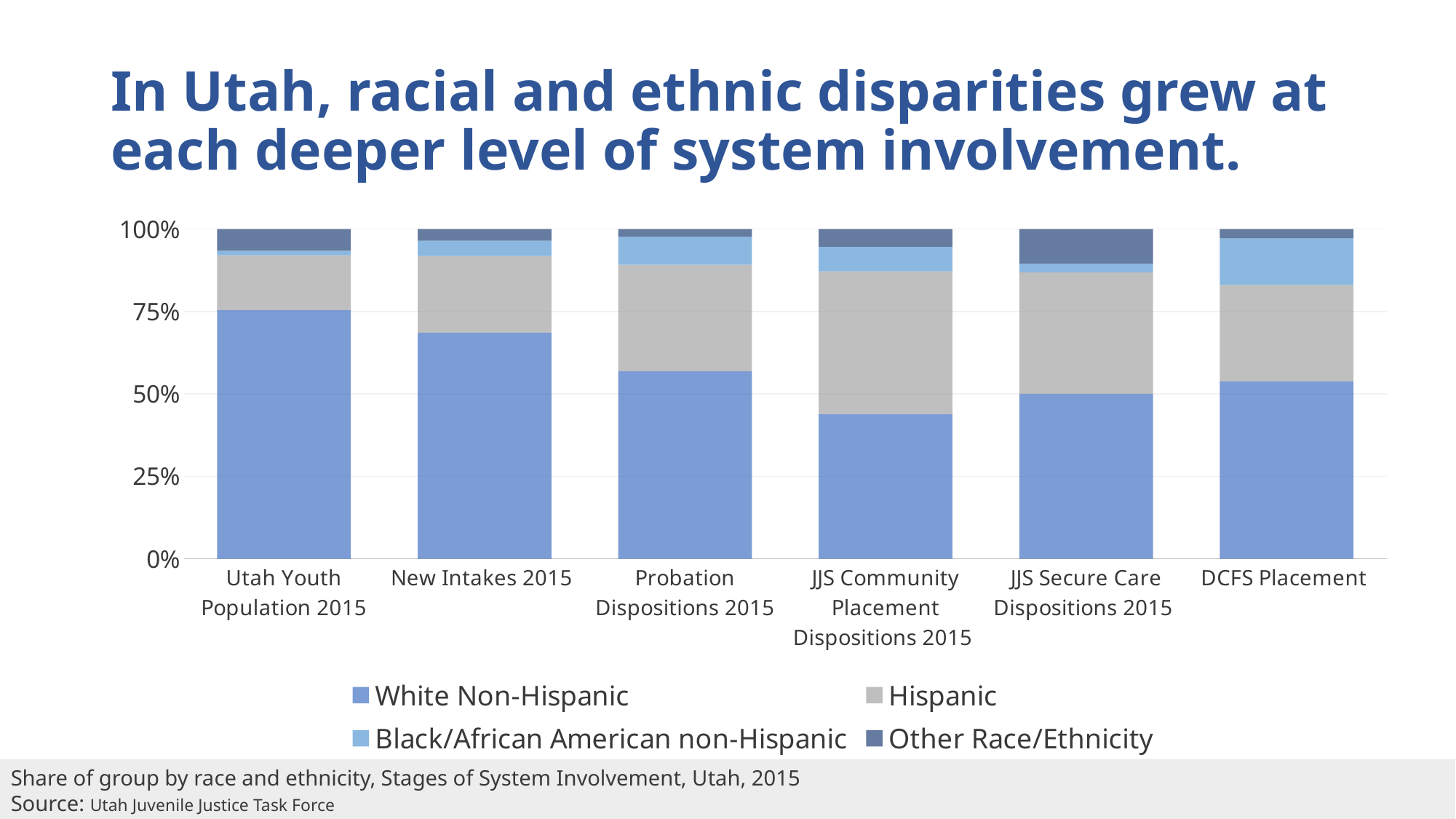
What is the total of the stacked bar for New Intakes 2015? 100% Does the White Non-Hispanic share rise or fall from Utah Youth Population 2015 to JJS Community Placement Dispositions 2015? fall Is the White Non-Hispanic share for Utah Youth Population 2015 greater or less than 50%? greater Is the White Non-Hispanic share for JJS Community Placement Dispositions 2015 greater or less than 50%? less How many series does the legend list? 4 How many categories are shown along the x axis? 6 Which has the larger White Non-Hispanic share, Utah Youth Population 2015 or JJS Secure Care Dispositions 2015? Utah Youth Population 2015 What kind of chart is shown on the slide? Stacked bar chart What is the source cited for the chart? Utah Juvenile Justice Task Force Which category has the largest White Non-Hispanic share? Utah Youth Population 2015 Is the White Non-Hispanic share for New Intakes 2015 greater or less than 75%? less Which category has the smallest White Non-Hispanic share? JJS Community Placement Dispositions 2015